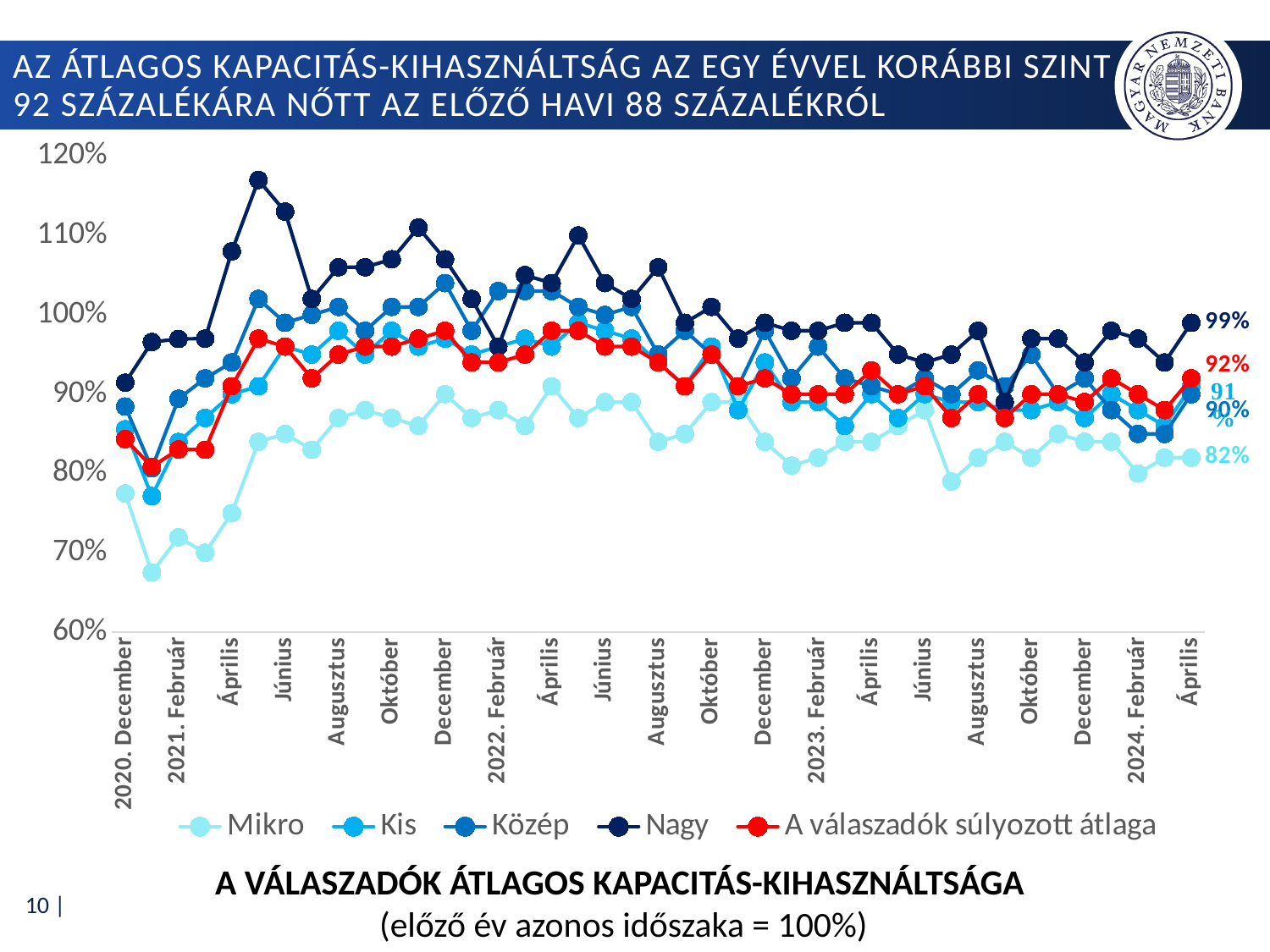
How many series does the legend list? 5 Which series has the lowest value at 2024 Április? Mikro Is the value of the Nagy series at 2021 Április greater or less than 100%? greater What kind of chart is shown on the slide? line chart Which series has the highest value at 2024 Április? Nagy At 2024 Április, which is larger: the Nagy value or the Mikro value? Nagy What is the value of the Mikro series at the last point (2024 Április)? 82% At 2024 Április, what is the difference between the Nagy value and the Mikro value? 17 percentage points Is the value of the Mikro series at 2020 December greater or less than 80%? less Which legend entry is drawn in red? A válaszadók súlyozott átlaga What is the value of 'A válaszadók súlyozott átlaga' at the last point (2024 Április)? 92% What is the value of the Nagy series at the last point (2024 Április)? 99%